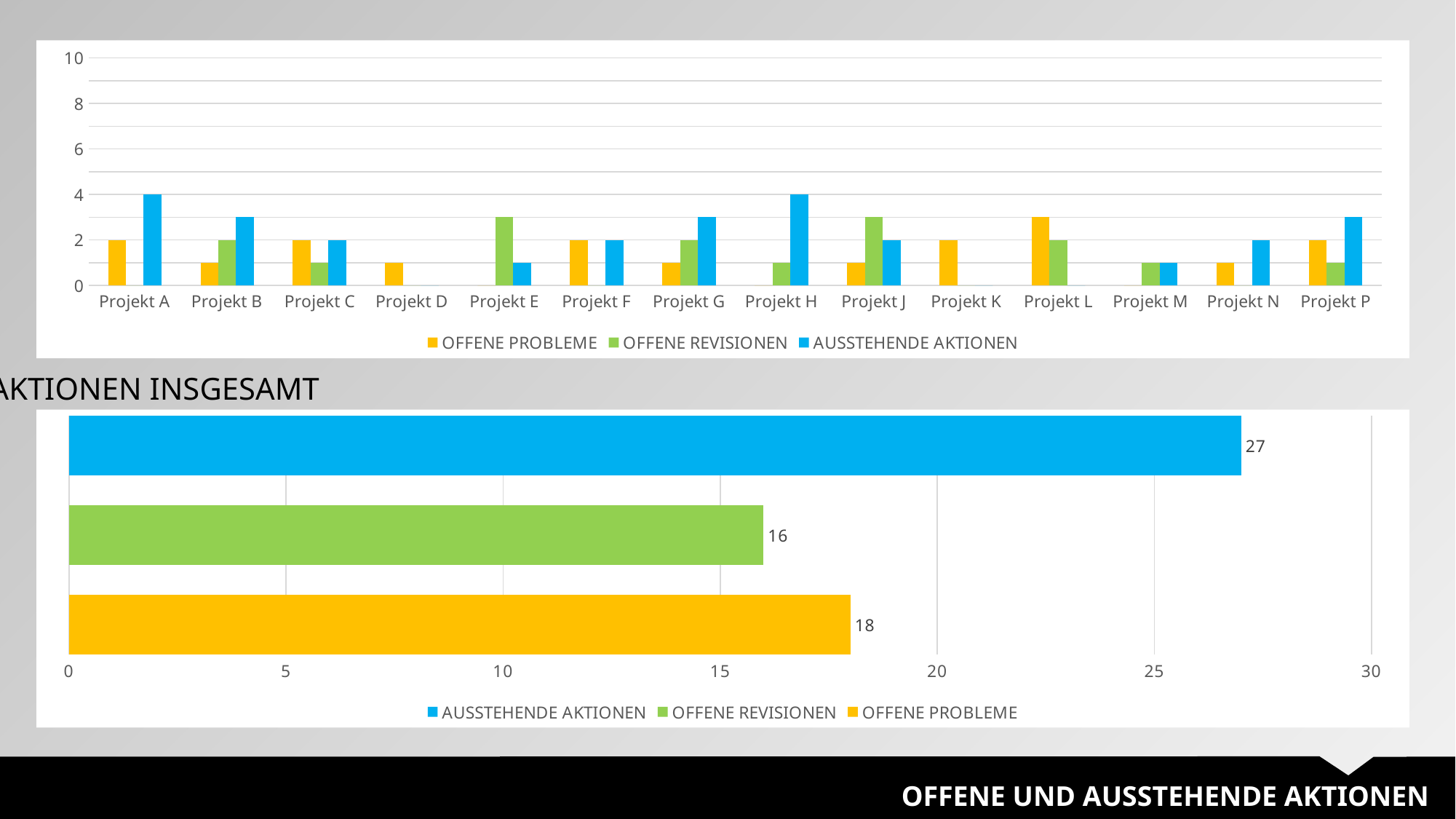
In the bottom chart (AKTIONEN INSGESAMT), which category has the highest value? AUSSTEHENDE AKTIONEN In the bottom chart (AKTIONEN INSGESAMT), what is the difference between AUSSTEHENDE AKTIONEN and OFFENE PROBLEME? 9 What kind of chart is the bottom chart (AKTIONEN INSGESAMT)? Bar chart In the top chart, how many series does the legend list? 3 In the top chart, what is the value of AUSSTEHENDE AKTIONEN for Projekt A? 4 In the bottom chart (AKTIONEN INSGESAMT), which is larger: OFFENE PROBLEME or OFFENE REVISIONEN? OFFENE PROBLEME In the bottom chart (AKTIONEN INSGESAMT), what is the value for AUSSTEHENDE AKTIONEN? 27 In the top chart, how many projects are shown on the x axis? 14 In the bottom chart (AKTIONEN INSGESAMT), what is the value for OFFENE REVISIONEN? 16 In the bottom chart (AKTIONEN INSGESAMT), which category has the lowest value? OFFENE REVISIONEN In the bottom chart (AKTIONEN INSGESAMT), what is the value for OFFENE PROBLEME? 18 In the top chart, is the value of AUSSTEHENDE AKTIONEN for Projekt H greater or less than 2? greater